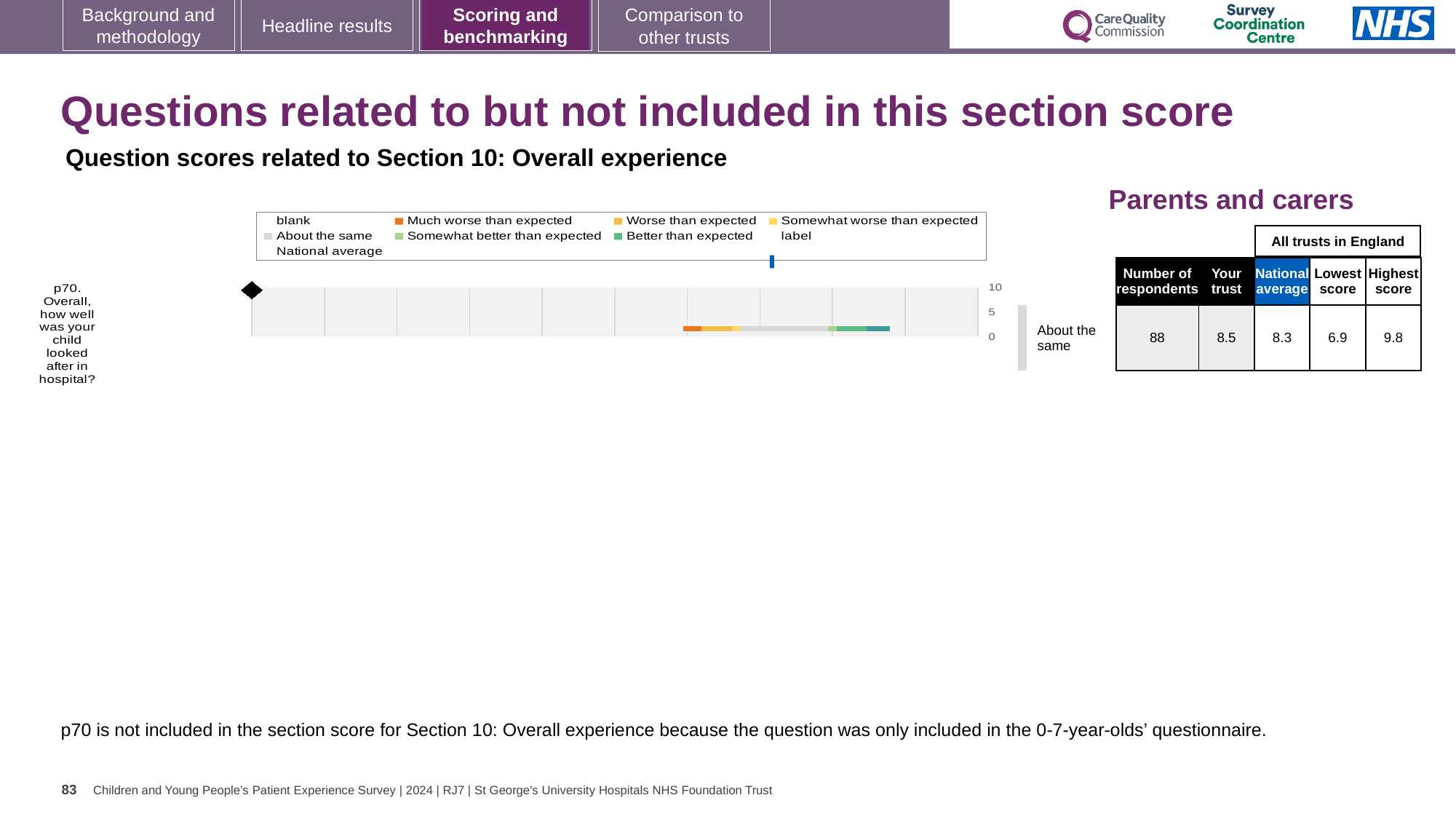
In the table beside the chart, what is the highest score among all trusts in England for p70? 9.8 In the table beside the chart, what is the lowest score among all trusts in England for p70? 6.9 How many survey questions are plotted in the chart? 1 Which question is plotted in the chart? p70. Overall, how well was your child looked after in hospital? What is the highest value shown on the chart's vertical axis? 10 In the table beside the chart, what is the 'Your trust' score for p70? 8.5 In the table beside the chart, what is the national average score for p70? 8.3 What kind of chart is shown for question p70? bar chart What category label is shown to the right of the p70 bar? About the same In the table beside the chart, what is the number of respondents for p70? 88 Which is larger for p70, the 'Your trust' score or the national average? Your trust What is the difference between the highest score and the lowest score for p70 in the table beside the chart? 2.9